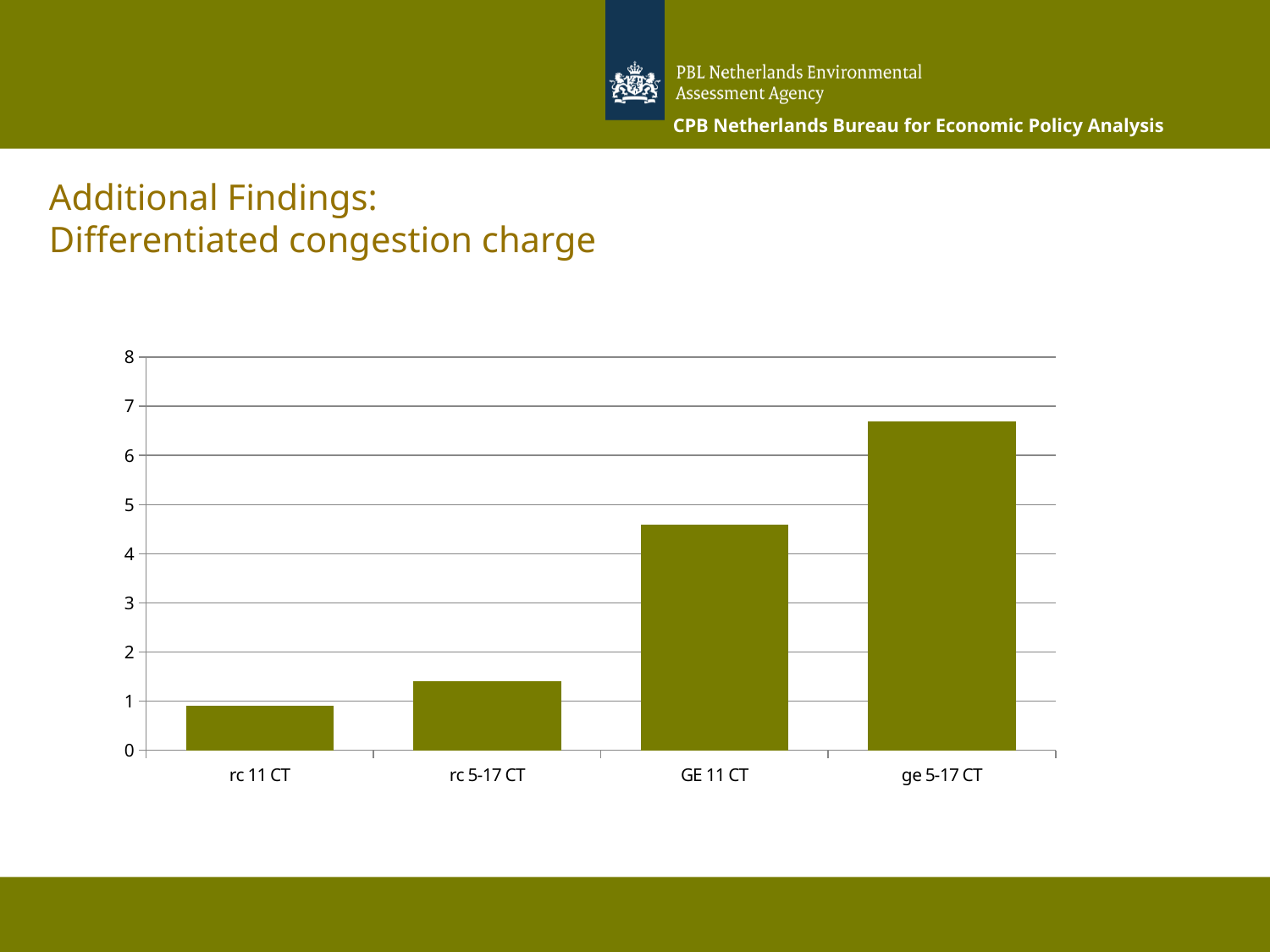
Is the value for ge 5-17 CT greater or less than 7? less Which is larger, the value for GE 11 CT or the value for rc 5-17 CT? GE 11 CT Is the value for rc 5-17 CT greater or less than 1? greater Which category has the highest bar in the chart? ge 5-17 CT How many categories are shown on the x axis of the chart? 4 What kind of chart is shown on the slide? bar chart Is the value for GE 11 CT greater or less than 5? less Do the bar values rise or fall from left to right along the x axis? rise What is the maximum value shown on the vertical axis of the chart? 8 Which category has the lowest bar in the chart? rc 11 CT